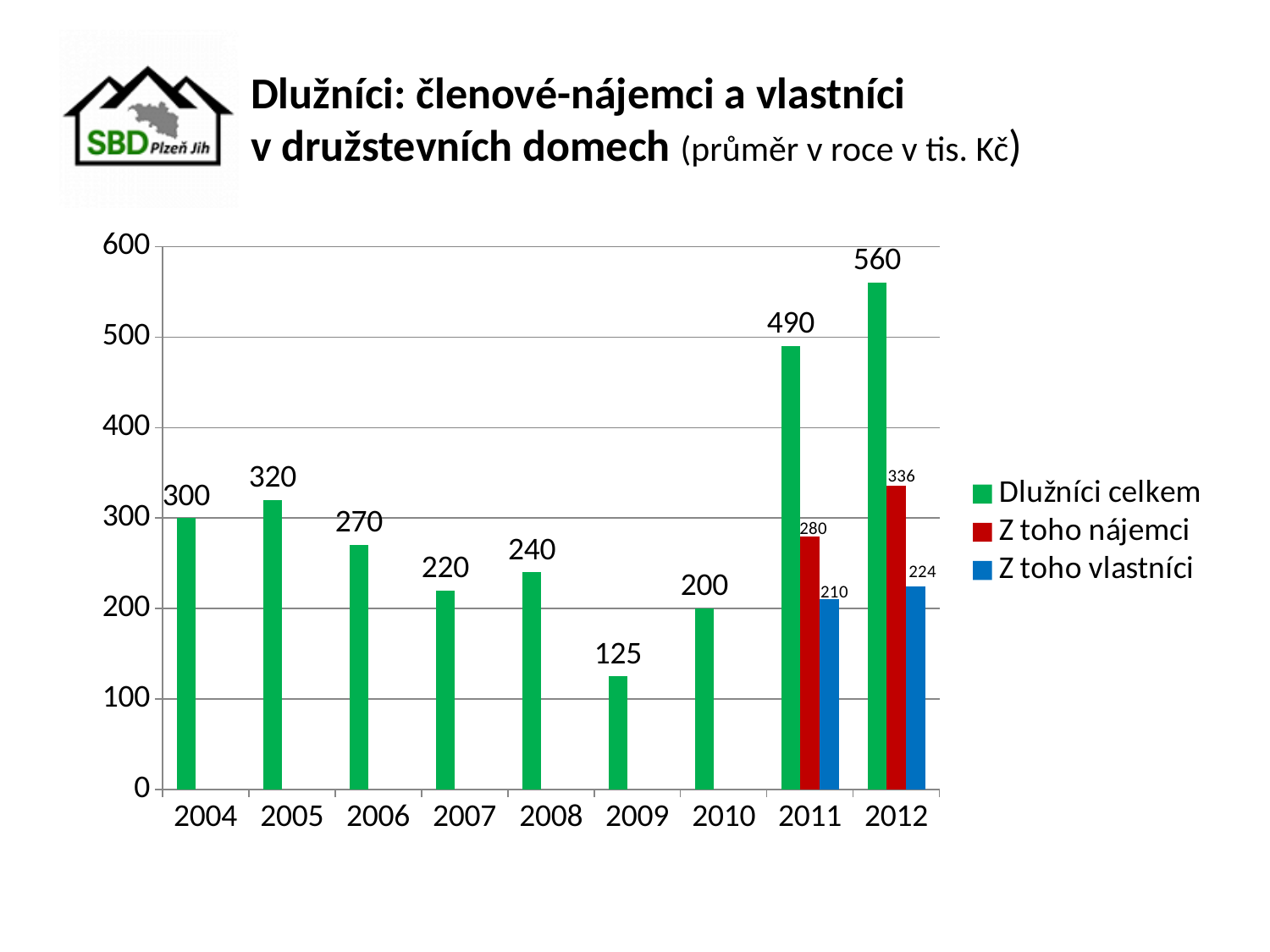
Which is larger in 2011: Z toho nájemci or Z toho vlastníci? Z toho nájemci What kind of chart is shown on the slide? bar chart How many series does the legend list? 3 What is the value of Z toho nájemci for 2012? 336 What is the difference between Dlužníci celkem in 2012 and in 2011? 70 Which colour represents Z toho vlastníci in the legend? blue What is the value of Dlužníci celkem for 2004? 300 How many years are shown on the x axis? 9 Which year has the lowest value of Dlužníci celkem? 2009 Did Dlužníci celkem rise or fall from 2009 to 2012? rise What is the value of Z toho vlastníci for 2011? 210 Which year has the highest value of Dlužníci celkem? 2012